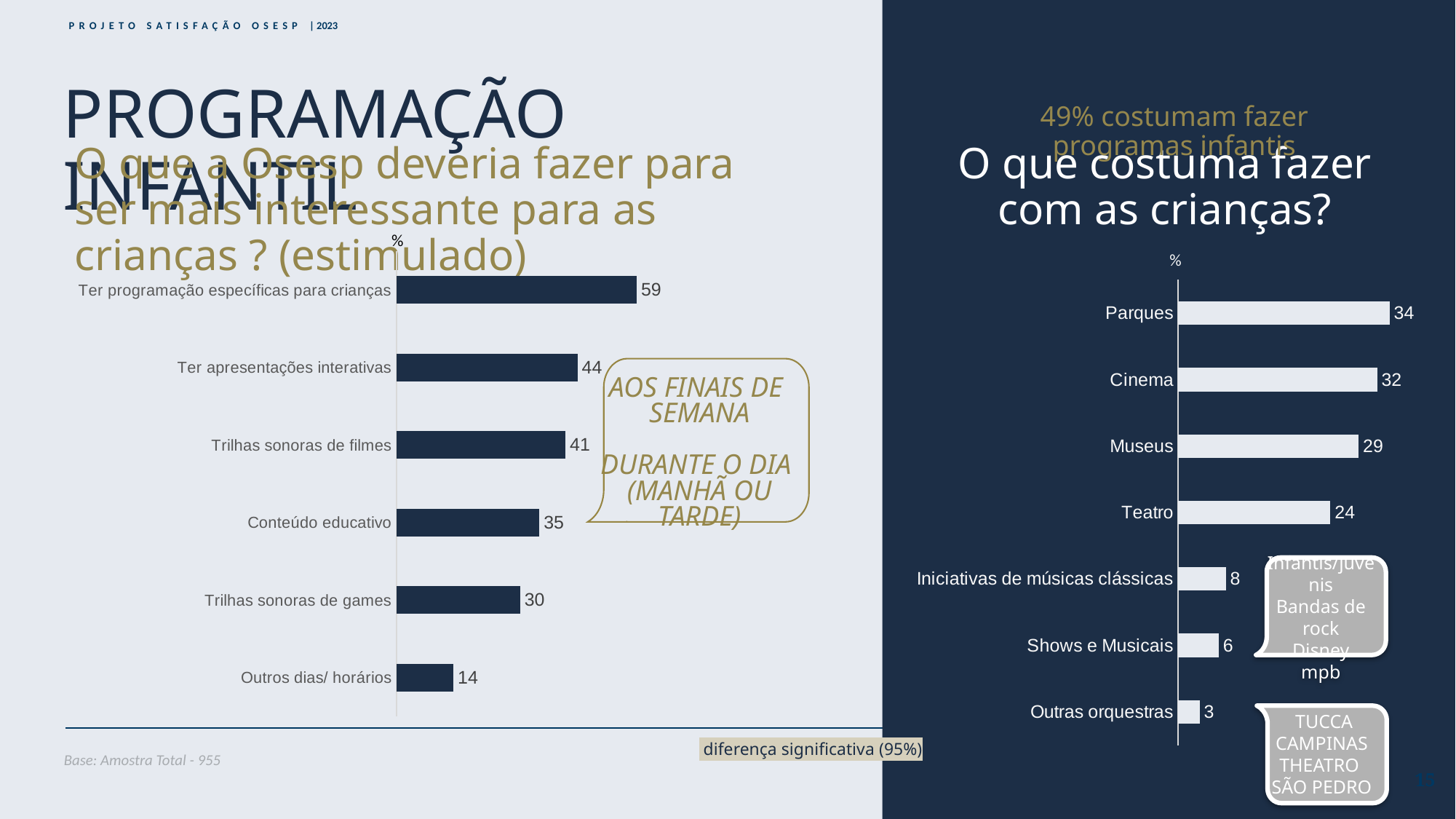
In the left chart, how many categories are shown? 6 In the left chart, what is the value for "Ter programação específicas para crianças"? 59 In the right chart, what is the value for "Outras orquestras"? 3 In the left chart, what is the value for "Trilhas sonoras de games"? 30 In the right chart, what is the difference between "Parques" and "Cinema"? 2 In the left chart, which category has the lowest value? Outros dias/ horários In the left chart, what is the difference between "Ter apresentações interativas" and "Conteúdo educativo"? 9 In the right chart, which category has the highest value? Parques In the right chart, which is larger, "Teatro" or "Shows e Musicais"? Teatro In the right chart, how many categories are shown? 7 What type of chart is the right chart? Bar chart In the right chart, what is the value for "Museus"? 29